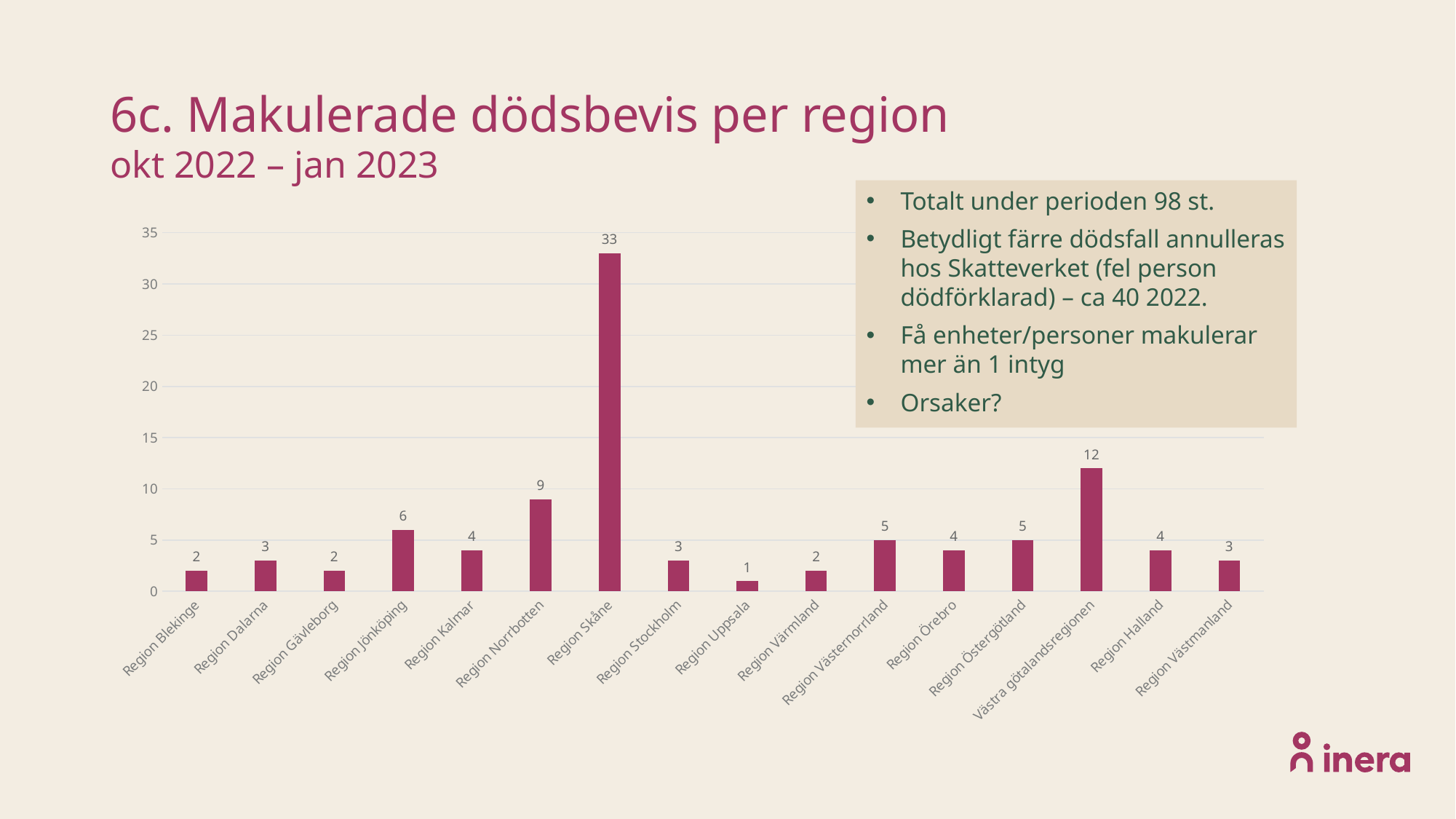
How many regions are shown on the x axis? 16 Which region has the lowest value? Region Uppsala What is the value for Västra götalandsregionen? 12 What kind of chart is shown on the slide? bar chart Which is larger, the value for Region Jönköping or the value for Region Kalmar? Region Jönköping Is the value for Region Skåne greater or less than 30? greater What is the value for Region Norrbotten? 9 Which region has the highest value? Region Skåne What is the value for Region Uppsala? 1 What is the title of the slide? 6c. Makulerade dödsbevis per region okt 2022 – jan 2023 What is the difference between the values for Region Skåne and Västra götalandsregionen? 21 What is the value for Region Skåne? 33